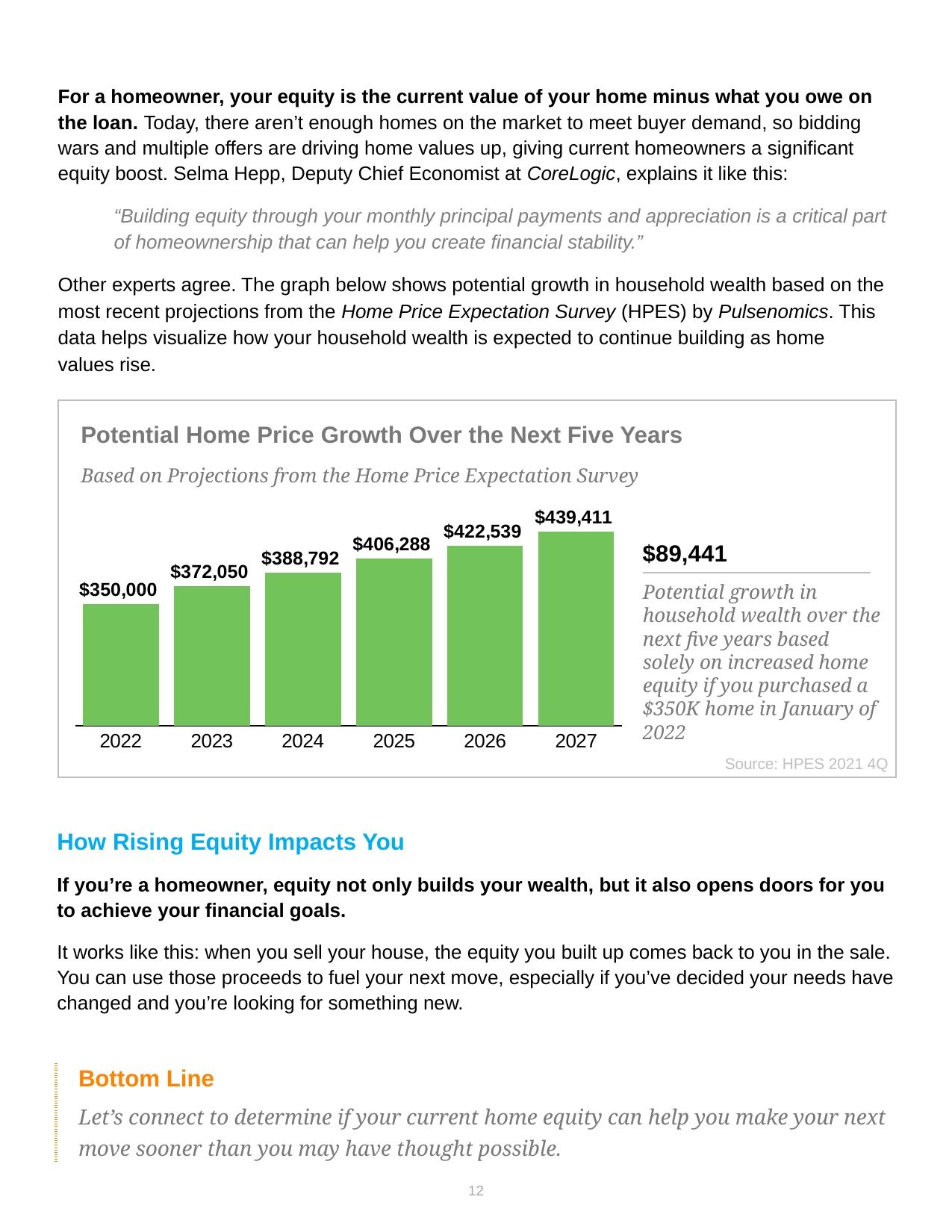
Which year has the lowest home price on the chart? 2022 What is the title of the chart? Potential Home Price Growth Over the Next Five Years Which is larger, the projected home price for 2023 or for 2025? 2025 Do the projected home prices rise or fall from 2022 to 2027? Rise What kind of chart is shown on the slide? Bar chart What is the difference between the projected home price in 2027 and the price in 2022? $89,411 What is the projected home price for 2027? $439,411 What is the home price shown for 2022? $350,000 What is the projected home price for 2024? $388,792 What is the difference between the projected home prices for 2026 and 2025? $16,251 Which year has the highest projected home price? 2027 How many years are shown on the chart? 6